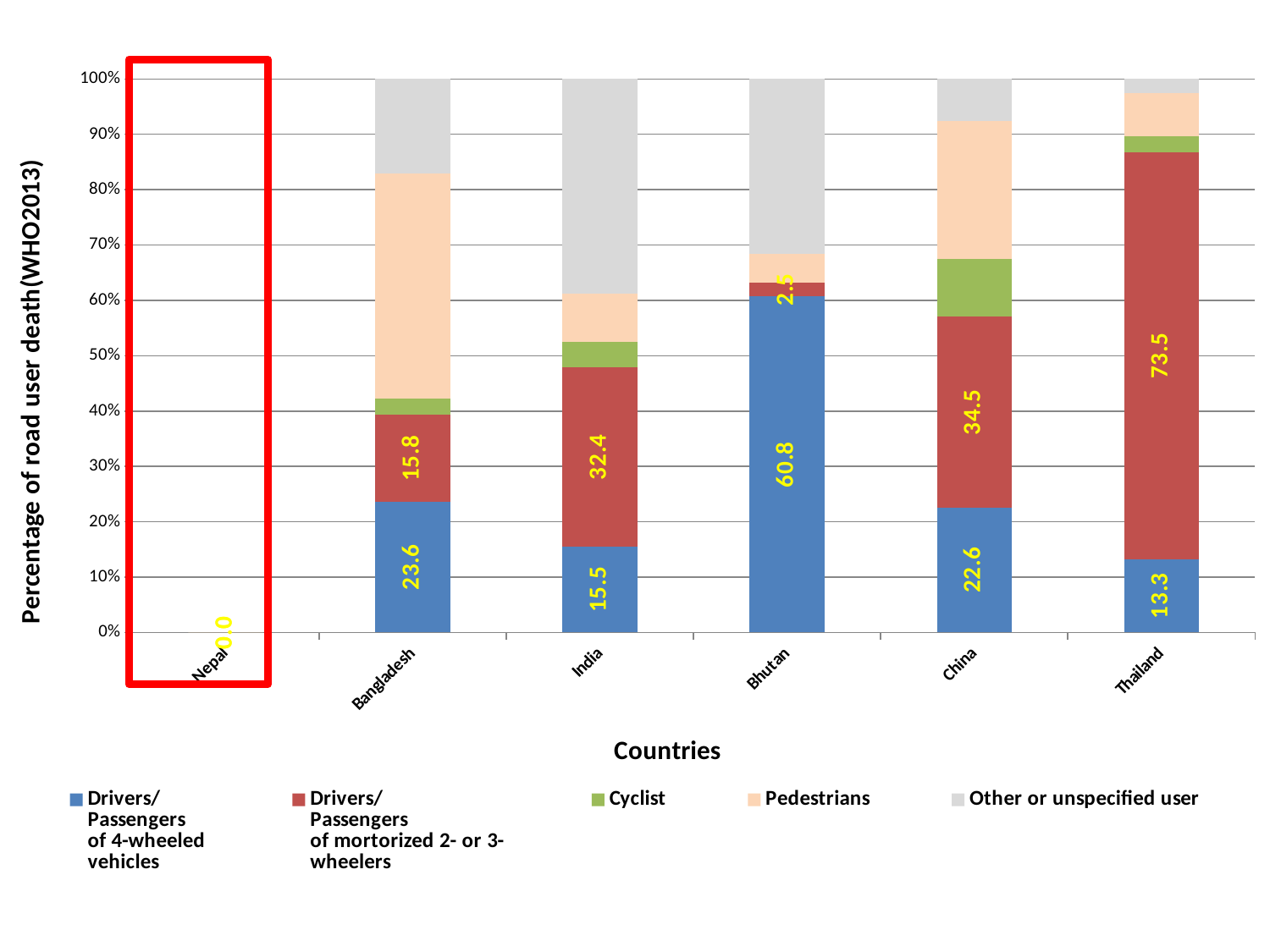
What is the value for drivers/passengers of 4-wheeled vehicles in Bhutan? 60.8 Which country has the highest percentage for drivers/passengers of motorized 2- or 3-wheelers? Thailand How many series does the legend list? 5 In Thailand, what is the difference between the motorized 2- or 3-wheelers value and the 4-wheeled vehicles value? 60.2 Which has a larger value for drivers/passengers of 4-wheeled vehicles, Bangladesh or India? Bangladesh What value is shown for Nepal for drivers/passengers of 4-wheeled vehicles? 0.0 What percentage of road user deaths in Thailand are drivers/passengers of motorized 2- or 3-wheelers? 73.5 What kind of chart is shown on the slide? Stacked bar chart Among the countries with a labelled value, which has the lowest percentage for drivers/passengers of motorized 2- or 3-wheelers? Bhutan In China, how much larger is the motorized 2- or 3-wheelers value than the 4-wheeled vehicles value? 11.9 Which country has the highest percentage for drivers/passengers of 4-wheeled vehicles? Bhutan How many countries are shown on the x axis? 6